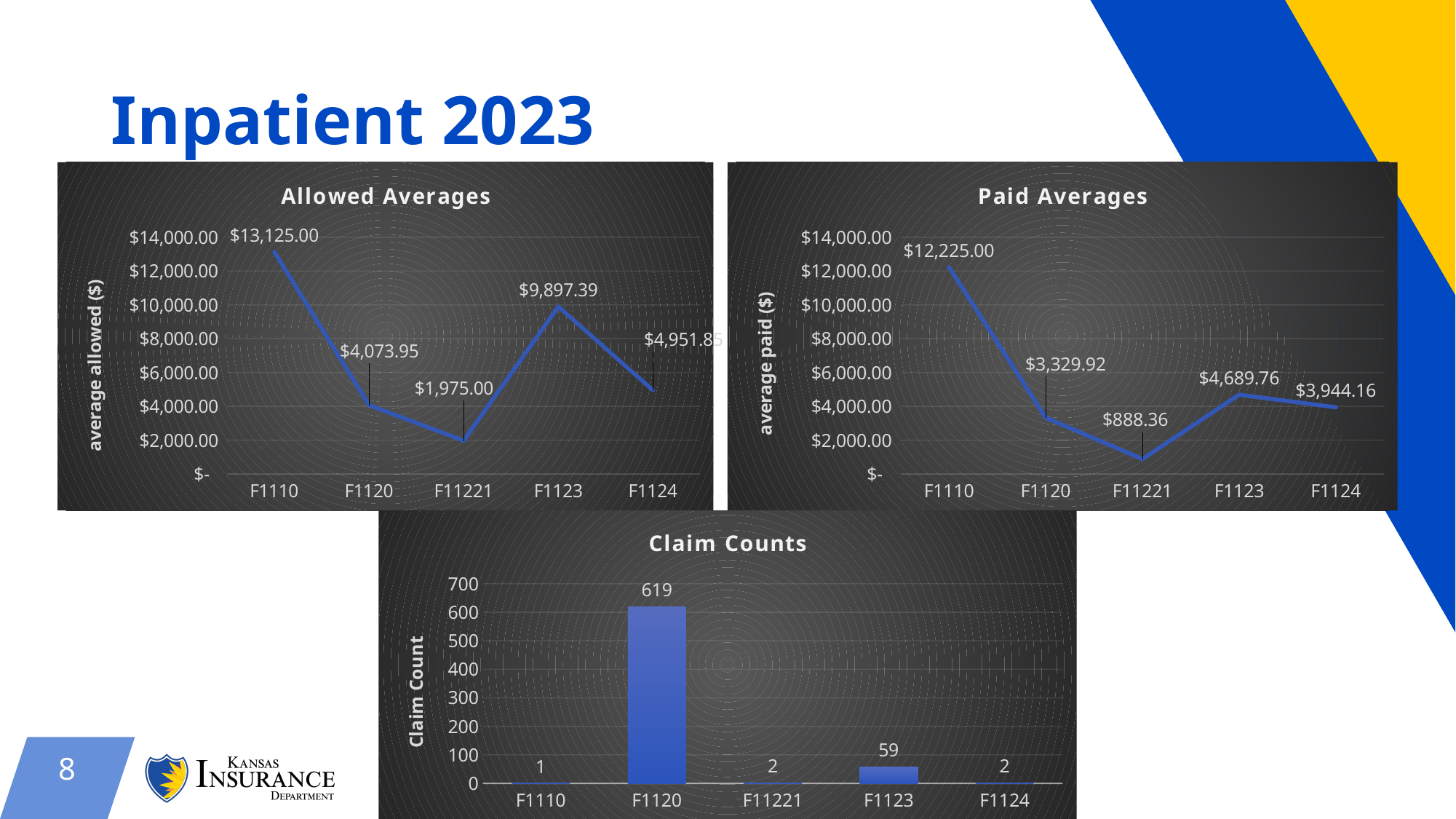
How many categories are shown on the x axis of the Claim Counts chart? 5 In the Claim Counts chart, which category has the highest claim count? F1120 In the Allowed Averages chart, which category has the highest value? F1110 In the Allowed Averages chart, what is the difference between the values for F1110 and F1123? $3,227.61 In the Paid Averages chart, what is the value for F11221? $888.36 What is the y-axis label of the Paid Averages chart? average paid ($) In the Paid Averages chart, which category has the lowest value? F11221 In the Allowed Averages chart, what is the value for F1123? $9,897.39 What kind of chart is the Claim Counts chart? Bar chart In the Paid Averages chart, which is larger, the value for F1123 or the value for F1124? F1123 In the Claim Counts chart, what is the difference between the claim counts for F1120 and F1123? 560 In the Claim Counts chart, what is the claim count for F1123? 59